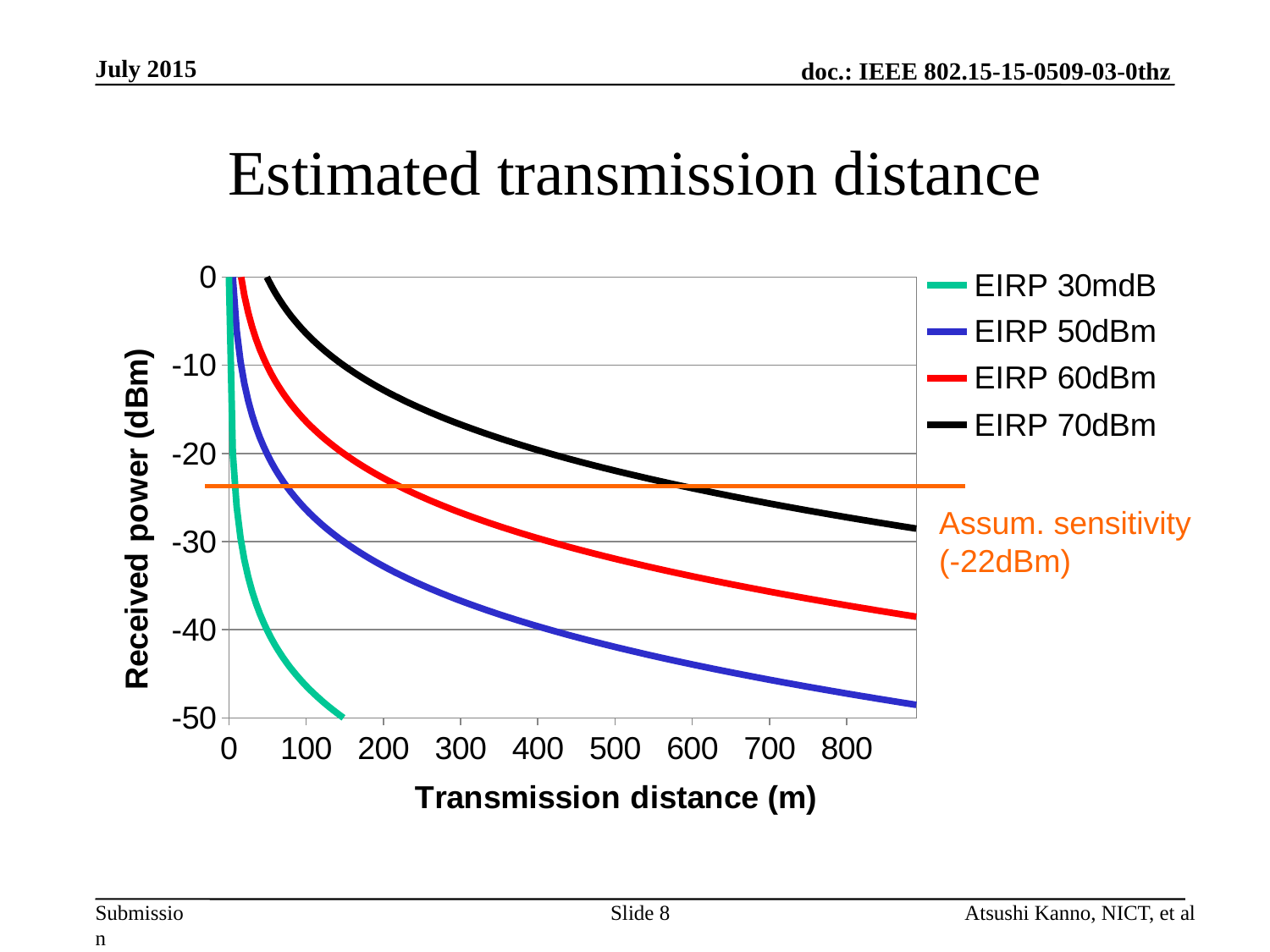
How many series does the chart legend list? 4 What is the label of the x axis? Transmission distance (m) Is the received power for EIRP 50dBm at 800 m greater or less than -40 dBm? less Which series has the highest received power at a transmission distance of 400 m? EIRP 70dBm What is the title of the chart? Estimated transmission distance Is the received power for EIRP 70dBm at 200 m greater or less than -20 dBm? greater What kind of chart is shown on the slide? line chart Which series has the lowest received power at a transmission distance of 100 m? EIRP 30mdB What is the assumed sensitivity value marked by the orange horizontal line? -22dBm At a transmission distance of 400 m, which series has the larger received power, EIRP 70dBm or EIRP 50dBm? EIRP 70dBm Is the received power for EIRP 70dBm at 800 m greater or less than -30 dBm? greater Does the received power rise or fall as the transmission distance increases? fall